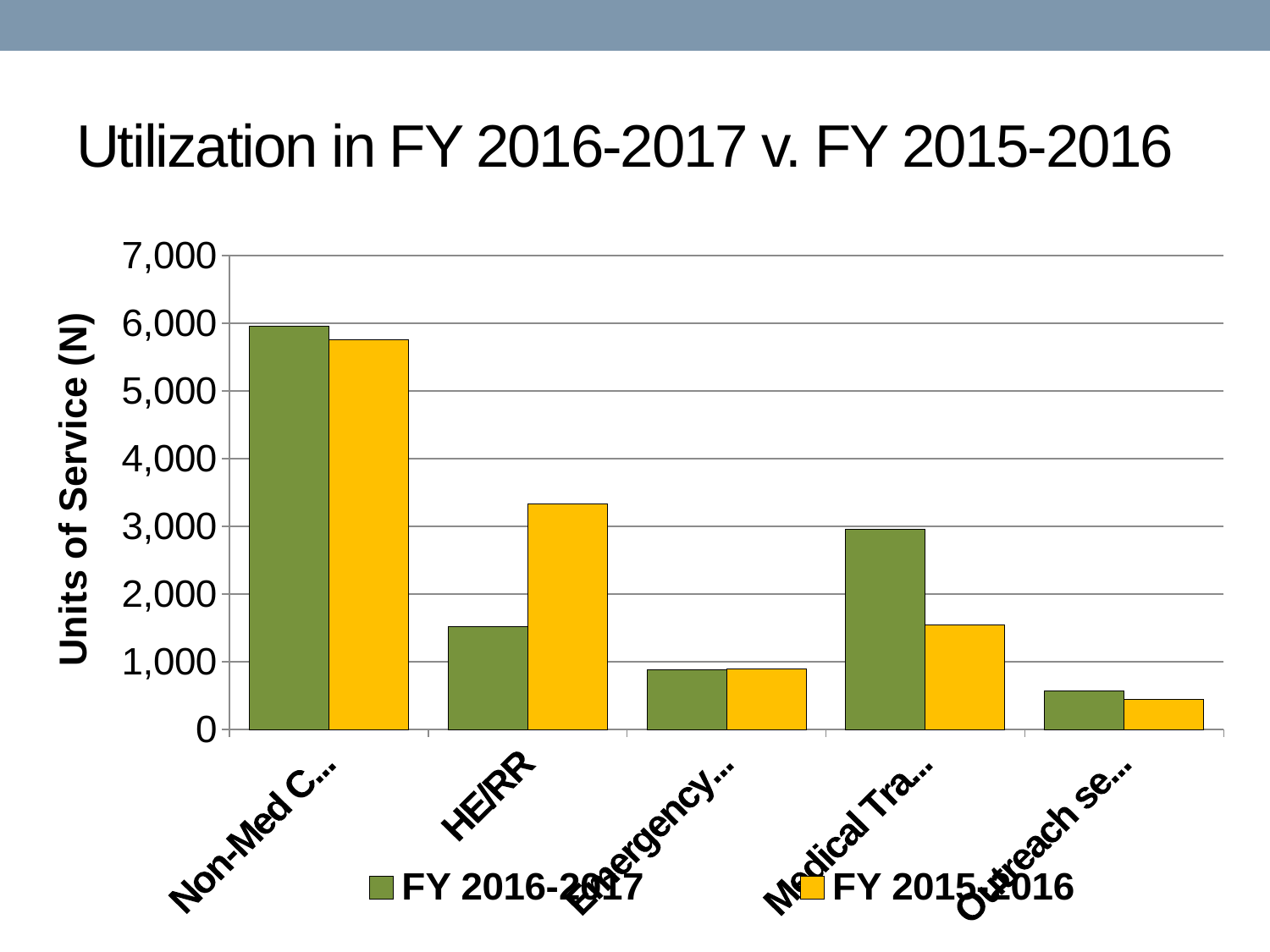
Which category has the highest FY 2016-2017 value? Non-Med C… (the first category) Is the FY 2015-2016 value for the fourth category (Medical Tra…) greater or less than 2,000? less For HE/RR, which series has the larger value, FY 2016-2017 or FY 2015-2016? FY 2015-2016 Is the FY 2016-2017 value for HE/RR greater or less than 2,000? less Which category has the lowest FY 2015-2016 value? Outreach se… (the last category) For the fourth category (Medical Tra…), which series has the larger value, FY 2016-2017 or FY 2015-2016? FY 2016-2017 Is the FY 2016-2017 value for the first category (Non-Med C…) greater or less than 5,000? greater What kind of chart is shown on the slide? Bar chart What is the title of the vertical axis? Units of Service (N) How many categories are plotted along the x axis? 5 How many series does the legend list? 2